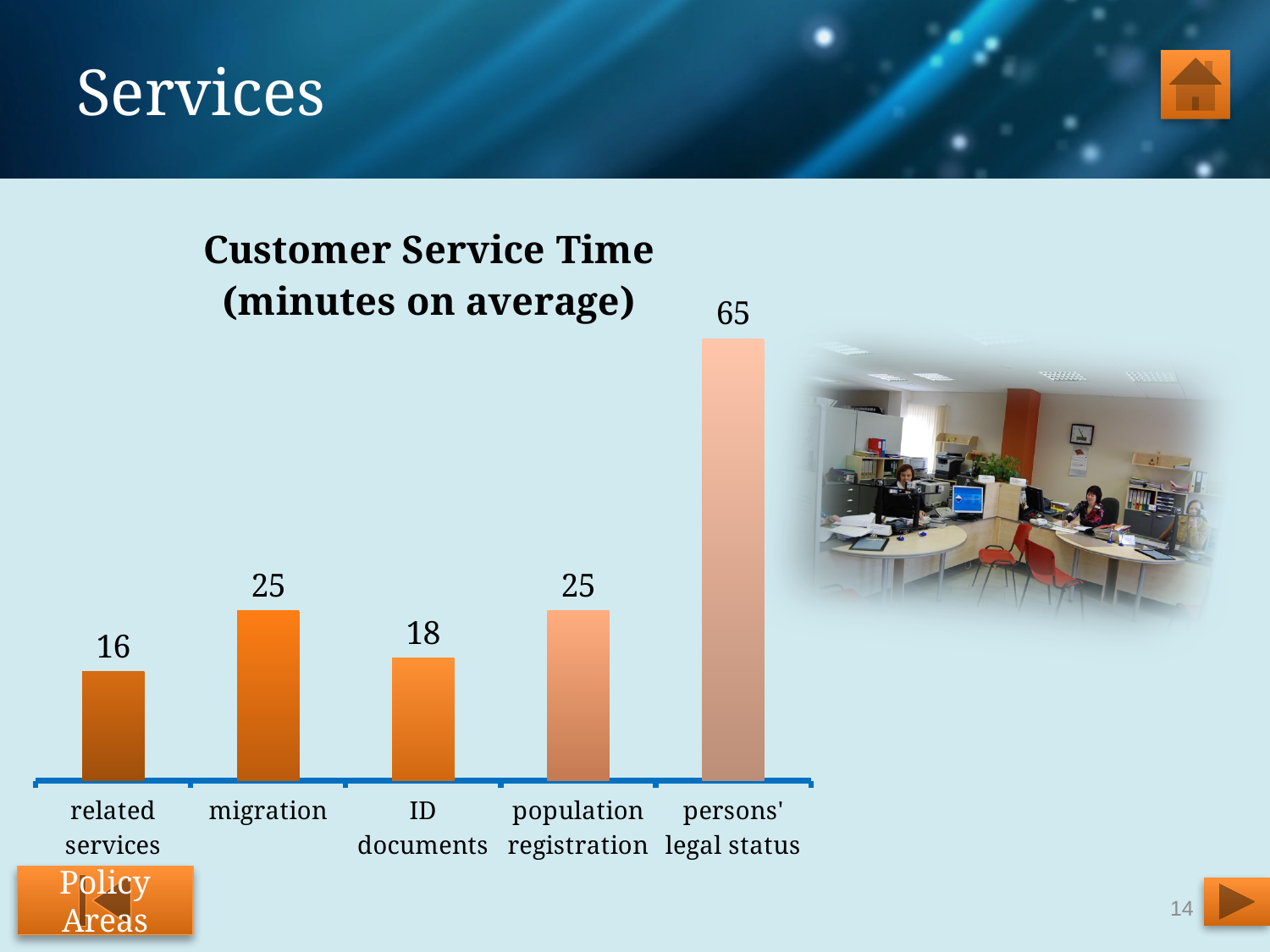
What is the difference in average customer service time between ID documents and related services? 2 Which has a longer average customer service time, migration or ID documents? migration Which category has the lowest average customer service time? related services What is the difference in average customer service time between persons' legal status and migration? 40 What is the title of the chart? Customer Service Time (minutes on average) Which category has the highest average customer service time? persons' legal status How many categories are shown in the chart? 5 What is the average customer service time for persons' legal status? 65 Which two categories have the same average customer service time of 25 minutes? migration and population registration What is the average customer service time for related services? 16 What is the average customer service time for ID documents? 18 What kind of chart is shown on the slide? bar chart